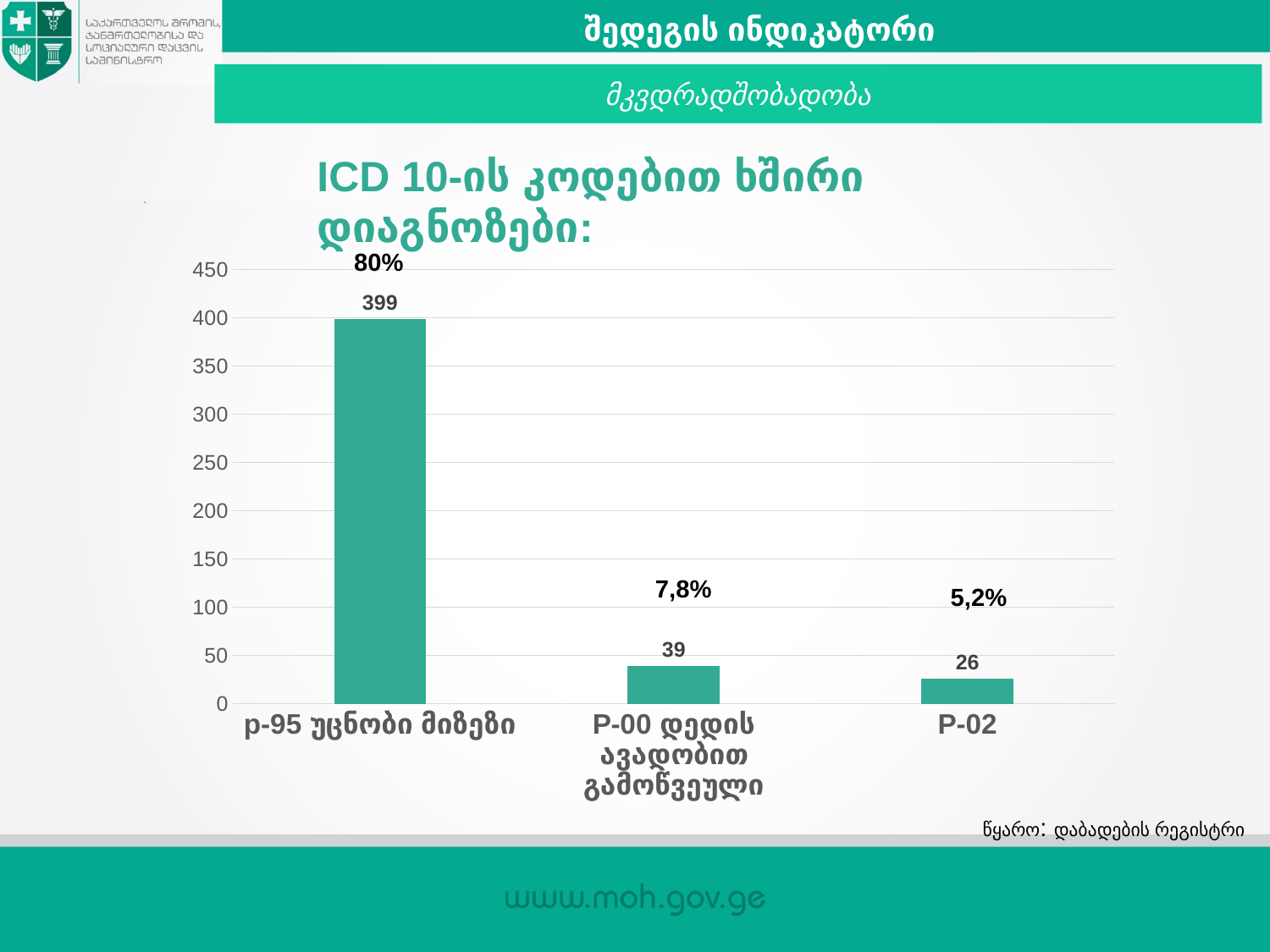
What value is shown for the category "p-95 უცნობი მიზეზი"? 399 What is the difference between the values for "p-95 უცნობი მიზეზი" and "P-00 დედის ავადობით გამოწვეული"? 360 What is the difference between the values for "P-00 დედის ავადობით გამოწვეული" and "P-02"? 13 What kind of chart is shown on the slide? bar chart What percentage label is shown above the bar for "p-95 უცნობი მიზეზი"? 80% Which category has the highest value? p-95 უცნობი მიზეზი How many categories are shown in the chart? 3 Which category has the lowest value? P-02 What value is shown for the category "P-02"? 26 Which is larger, the value for "P-00 დედის ავადობით გამოწვეული" or the value for "P-02"? P-00 დედის ავადობით გამოწვეული What percentage label is shown above the bar for "P-02"? 5,2% What value is shown for the category "P-00 დედის ავადობით გამოწვეული"? 39